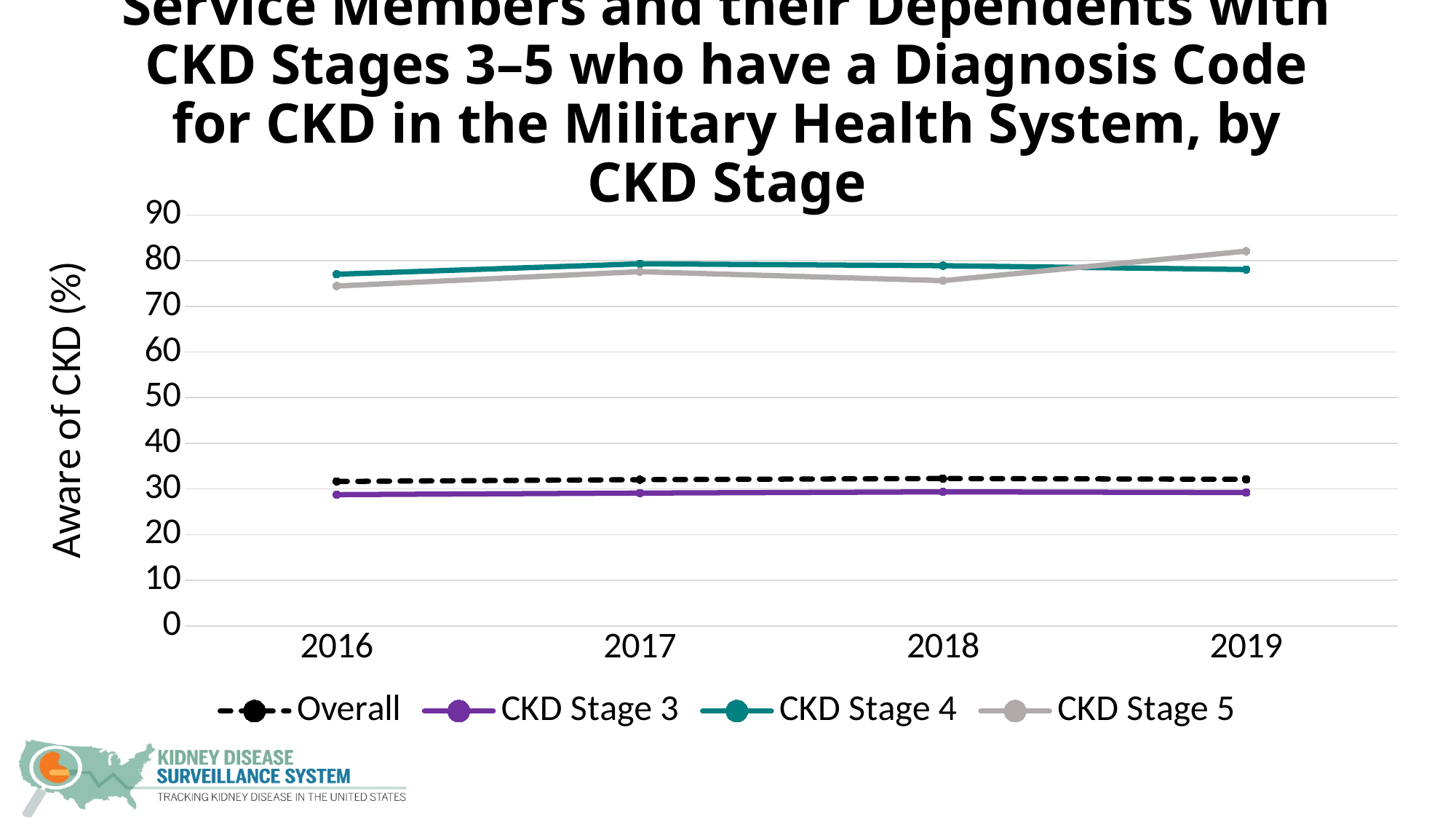
Which series has the lowest value in 2016? CKD Stage 3 What kind of chart is shown on the slide? Line chart Is the value for CKD Stage 5 in 2019 greater or less than 80? greater What is the label on the y axis? Aware of CKD (%) In 2019, which is larger: the value for CKD Stage 5 or CKD Stage 4? CKD Stage 5 Is the value for CKD Stage 3 in 2018 greater or less than 40? less Which series has the highest value in 2019? CKD Stage 5 How many years are shown on the x axis? 4 In 2017, which is larger: the value for CKD Stage 4 or CKD Stage 3? CKD Stage 4 Is the value for CKD Stage 5 in 2016 greater or less than 80? less How many series does the legend list? 4